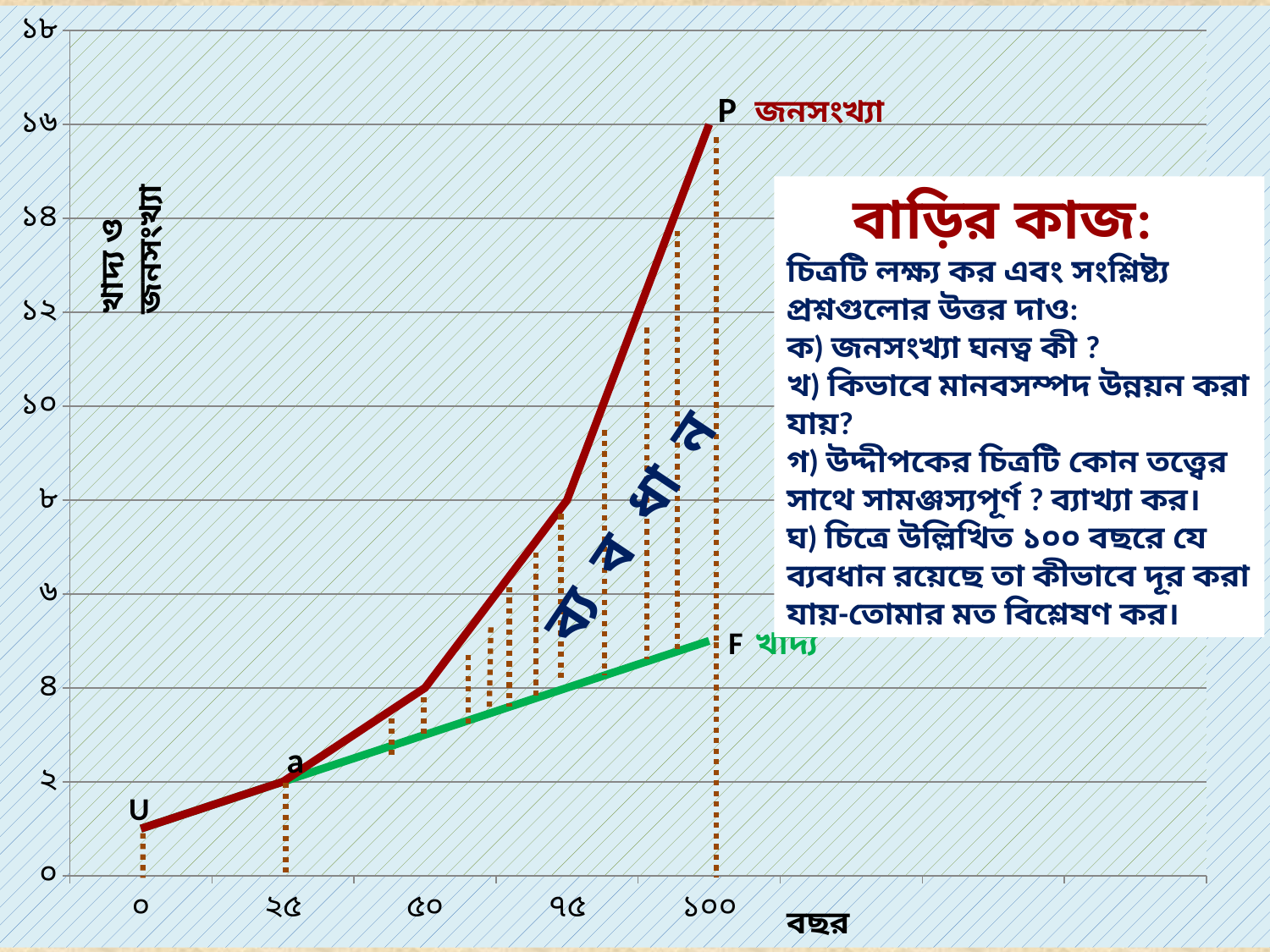
What kind of chart is shown on the slide? line chart Is the value of the খাদ্য (green) line at year ১০০ (point F) greater or less than ৪? greater Is the value of the খাদ্য (green) line at year ১০০ (point F) greater or less than ৬? less What is the label of the x axis of the chart? বছর What is the value of the জনসংখ্যা (red) line at year ১০০ (point P)? ১৬ How many lines are plotted on the chart? 2 What is the value of the জনসংখ্যা (red) line at year ৭৫? ৮ What is the value of the জনসংখ্যা (red) line at year ২৫ (point a)? ২ What is the value of the জনসংখ্যা (red) line at year ৫০? ৪ Does the জনসংখ্যা (red) line rise or fall as the year increases from ০ to ১০০? rise What is the difference between the জনসংখ্যা line's value at year ১০০ and at year ৭৫? ৮ At year ১০০, which line is higher: জনসংখ্যা or খাদ্য? জনসংখ্যা